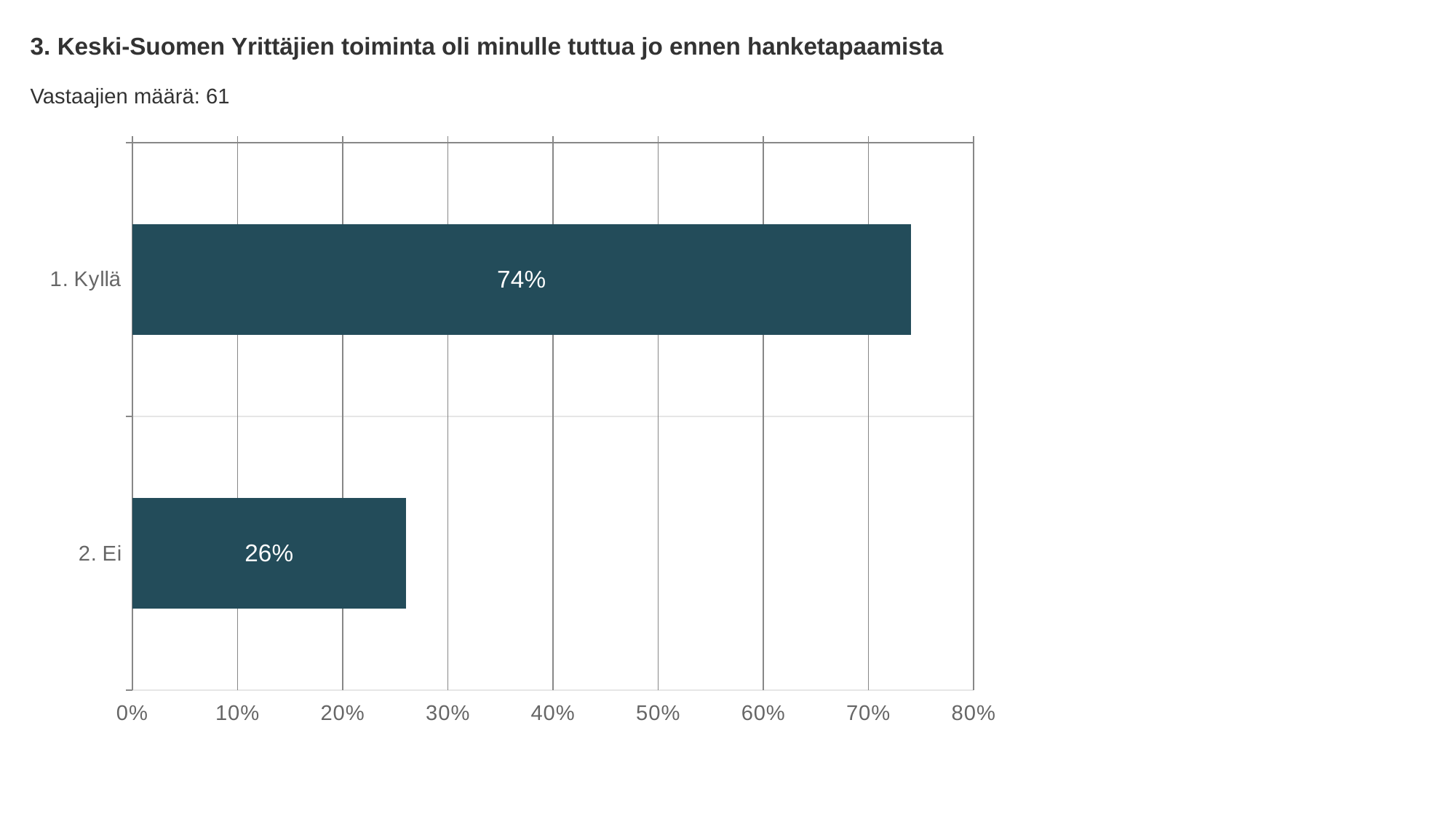
What is the value for "1. Kyllä"? 74% What is the number of respondents (Vastaajien määrä) stated on the slide? 61 Which category has the highest value? 1. Kyllä Is the value for "2. Ei" greater or less than 30%? less How many categories are shown in the chart? 2 Which category has the lowest value? 2. Ei Is the value for "1. Kyllä" greater or less than 70%? greater What is the maximum value shown on the x axis? 80% Which is larger, the value for "1. Kyllä" or the value for "2. Ei"? 1. Kyllä What kind of chart is shown on the slide? bar chart What is the value for "2. Ei"? 26% What is the difference between the values for "1. Kyllä" and "2. Ei"? 48%